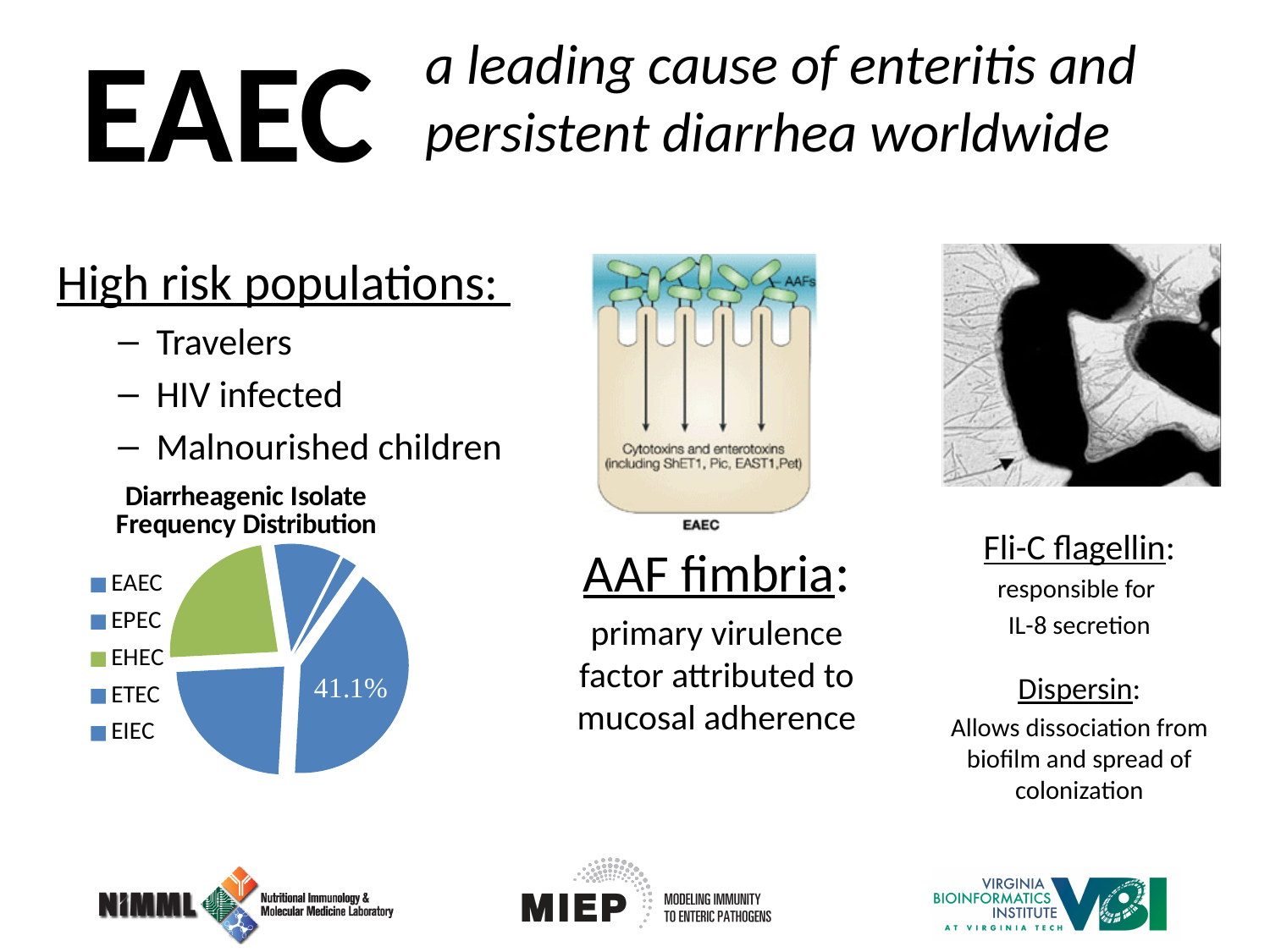
In the pie chart, which slice is larger, EAEC or EHEC? EAEC What share of the pie does the EAEC slice represent? 41.1% Which category is listed first in the pie chart legend? EAEC Which category has the largest slice in the pie chart? EAEC How many categories does the legend of the pie chart list? 5 What kind of chart is the "Diarrheagenic Isolate Frequency Distribution" chart? pie chart What is the title of the pie chart on the slide? Diarrheagenic Isolate Frequency Distribution Which category in the pie chart legend is shown in green? EHEC Is the share for EAEC in the pie chart greater or less than 40%? greater What percentage is printed on the largest slice of the pie chart? 41.1%